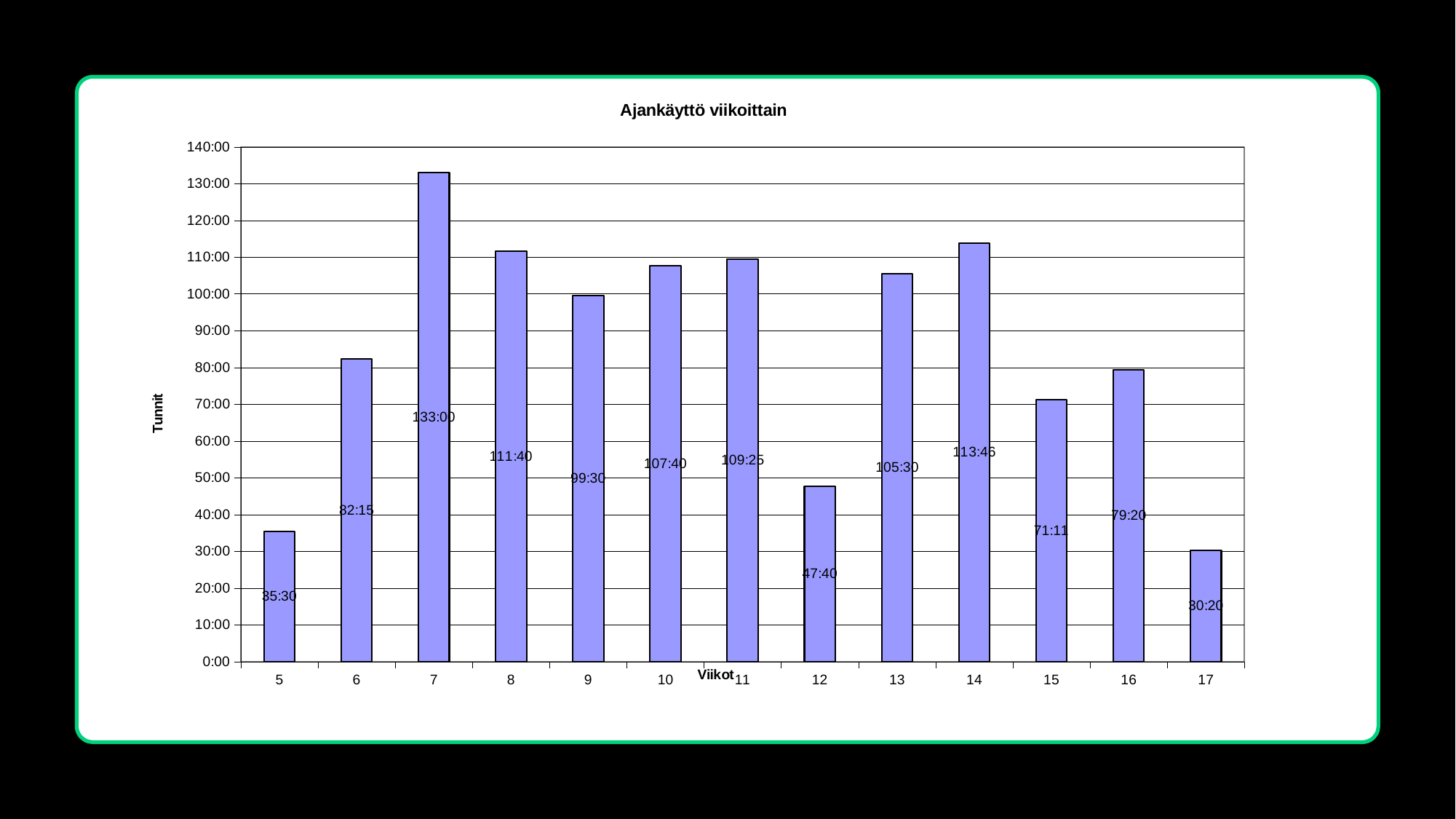
What is the difference between the value for week 8 and the value for week 9? 12:10 What is the value for week 12? 47:40 What is the value for week 7? 133:00 Which is larger, the value for week 6 or the value for week 16? week 6 Which week has the lowest value? 17 What kind of chart is shown on the slide? bar chart Is the value for week 12 greater or less than 50:00? less What is the title of the chart? Ajankäyttö viikoittain What is the value for week 14? 113:46 What is the label of the y axis? Tunnit Which week has the highest value? 7 How many weeks are plotted on the chart? 13